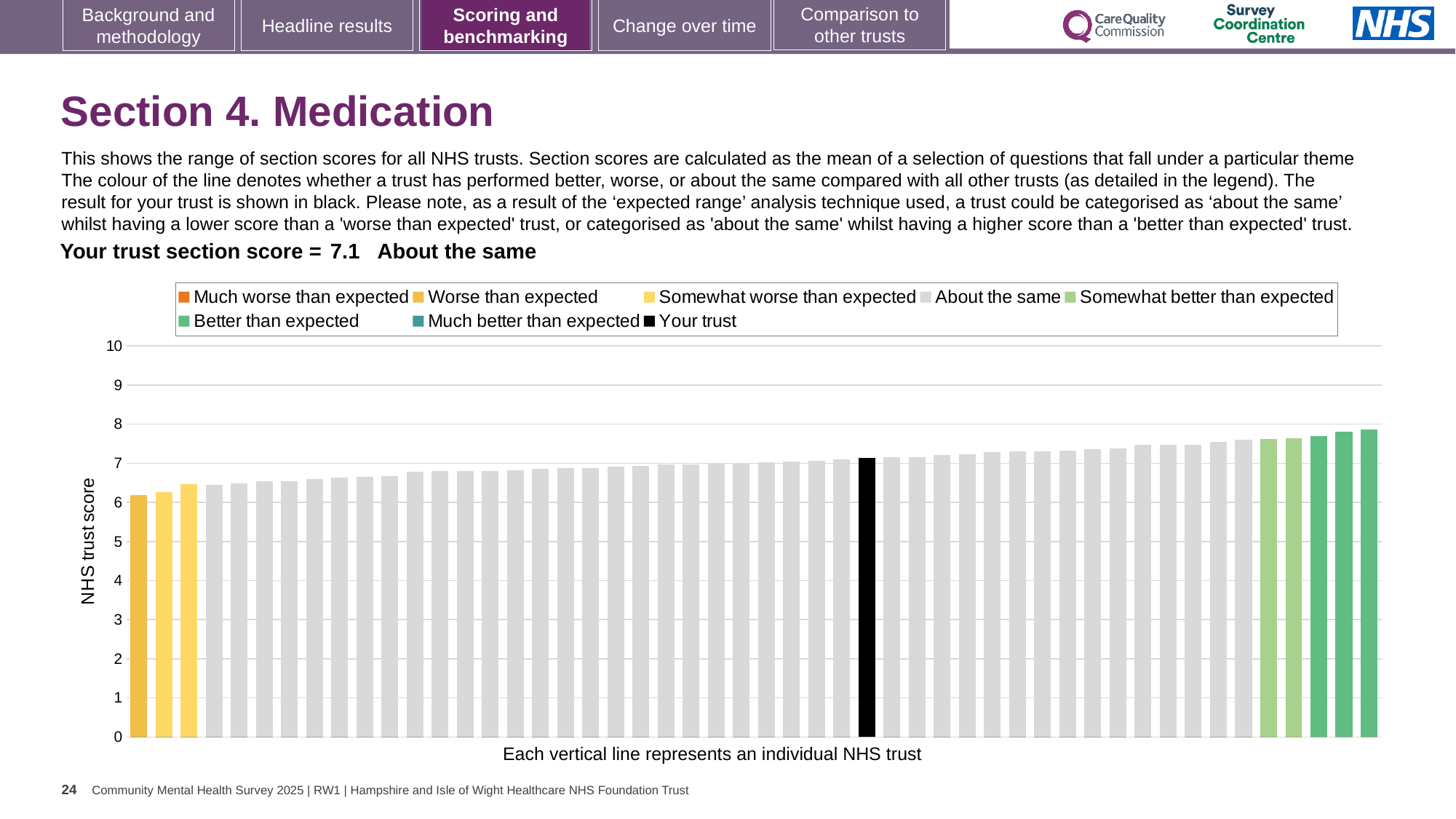
Which category is your trust placed in for the Medication section? About the same Is the value for your trust (the black bar) greater or less than 7? greater Is the value of the rightmost (highest) bar greater or less than 8? less Do the bar values rise or fall from left to right along the x axis? rise What colour is used for the bar representing your trust? black What is the label on the vertical axis of the chart? NHS trust score Is the bar for your trust higher or lower than the leftmost bar? higher What is the section score for your trust shown on the slide? 7.1 How many entries does the chart legend list? 8 Is the value of the leftmost bar greater or less than 7? less What kind of chart is shown on the slide? bar chart